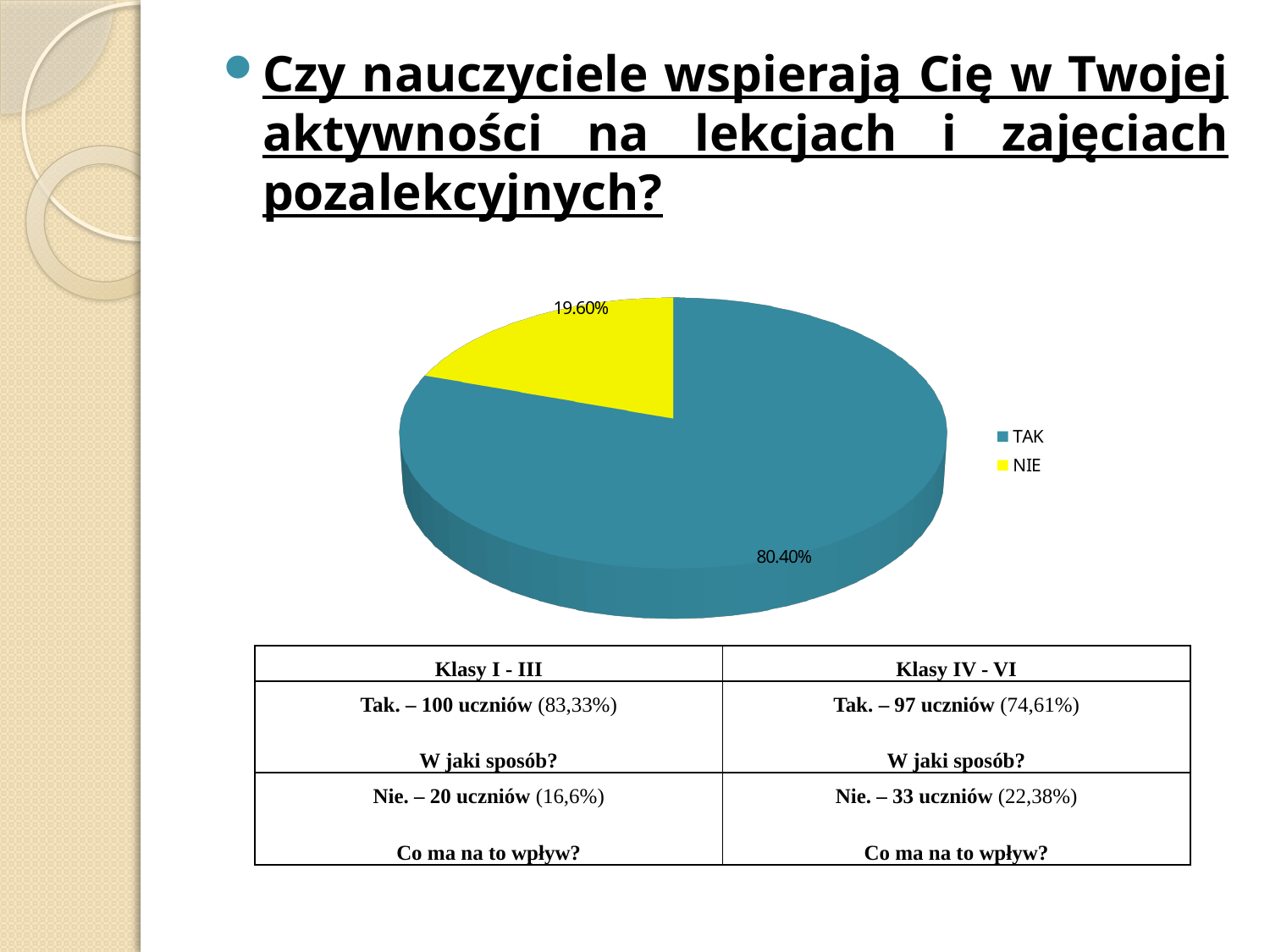
What colour is the TAK slice in the pie chart? teal What percentage of the pie chart is labelled for TAK? 80.40% How many entries does the legend of the pie chart list? 2 What is the difference in percentage points between the TAK and NIE slices? 60.80 Which slice of the pie chart is the largest? TAK How many slices does the pie chart have? 2 Which slice of the pie chart is the smallest? NIE What percentage of the pie chart is labelled for NIE? 19.60% Which is larger in the pie chart, TAK or NIE? TAK What kind of chart is shown on the slide? pie chart What colour is the NIE slice in the pie chart? yellow